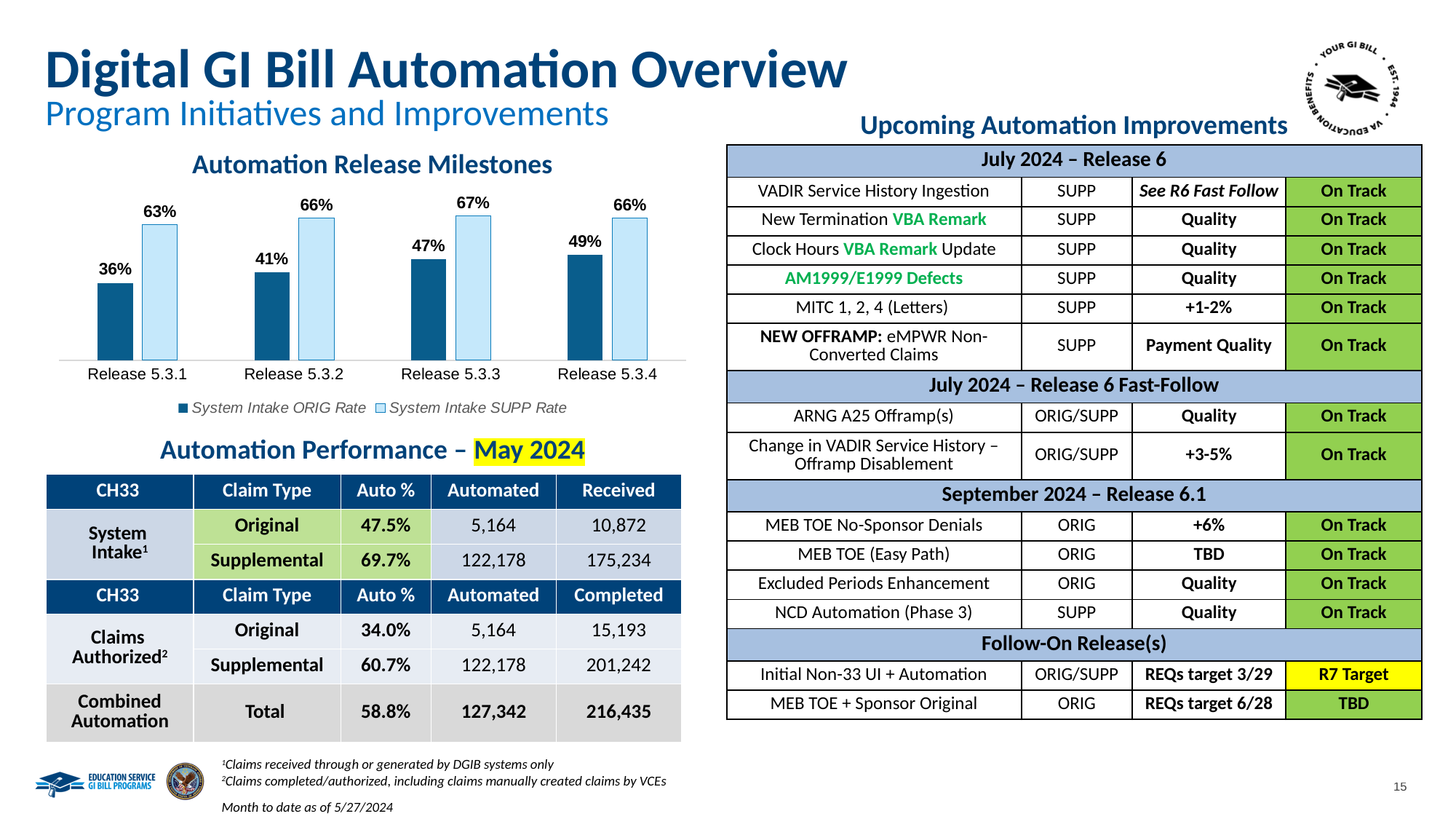
How many series does the legend of the Automation Release Milestones chart list? 2 In the Automation Release Milestones chart, which release has the highest System Intake SUPP Rate? Release 5.3.3 What kind of chart is the Automation Release Milestones chart? Bar chart In the Automation Release Milestones chart, what is the System Intake SUPP Rate for Release 5.3.3? 67% In the Automation Release Milestones chart, what is the System Intake ORIG Rate for Release 5.3.4? 49% In the Automation Release Milestones chart, which is larger for Release 5.3.4: the System Intake ORIG Rate or the System Intake SUPP Rate? System Intake SUPP Rate In the Automation Release Milestones chart, what is the difference between the System Intake SUPP Rate and the System Intake ORIG Rate for Release 5.3.2? 25% In the Automation Release Milestones chart, what is the System Intake ORIG Rate for Release 5.3.1? 36% In the Automation Release Milestones chart, does the System Intake ORIG Rate rise or fall from Release 5.3.1 to Release 5.3.4? Rise How many releases are shown on the x axis of the Automation Release Milestones chart? 4 What is the title of the chart on the slide? Automation Release Milestones In the Automation Release Milestones chart, which release has the lowest System Intake ORIG Rate? Release 5.3.1